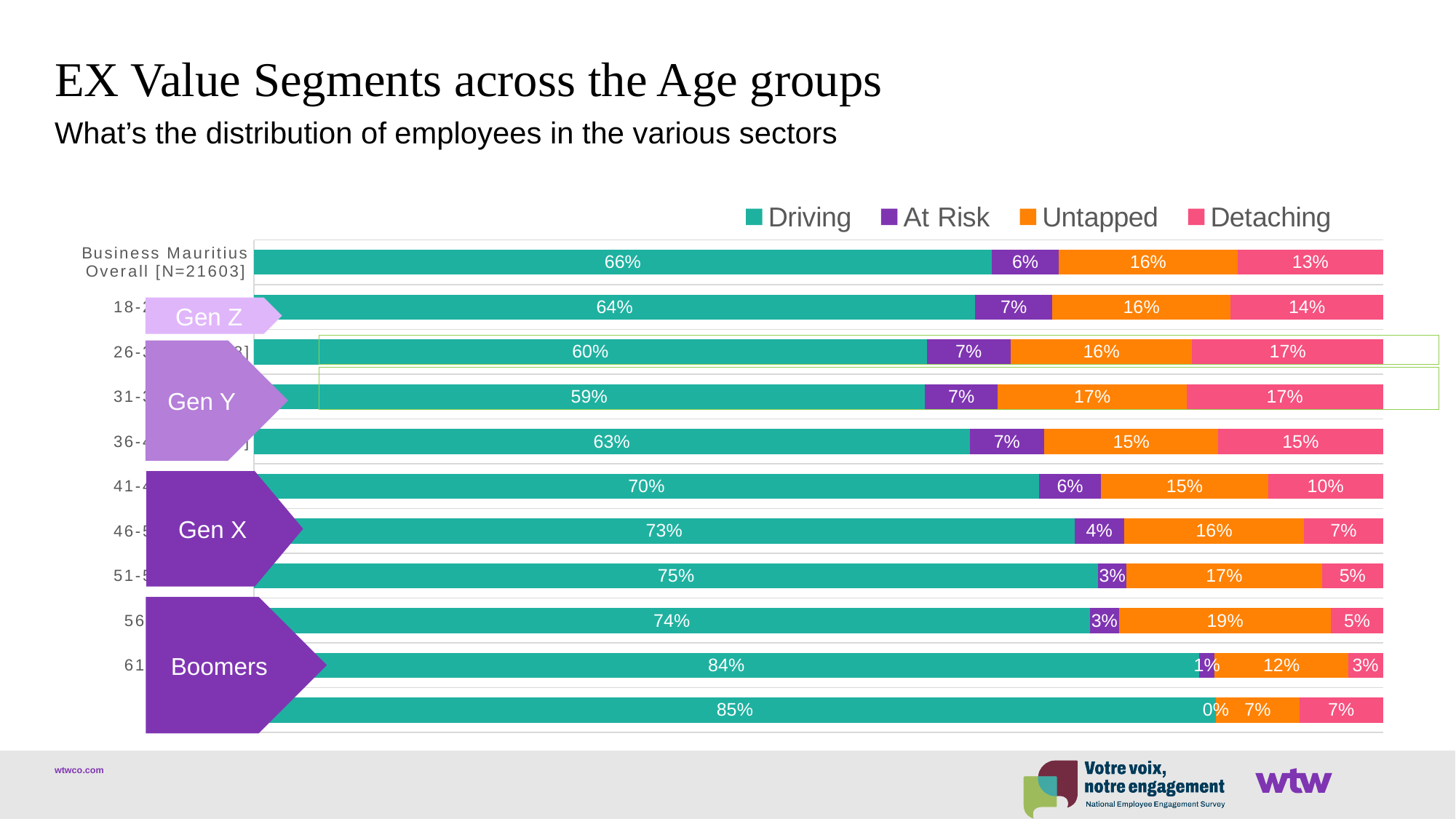
What is the highest Driving value shown on the chart? 85% What is the At Risk value for Business Mauritius Overall [N=21603]? 6% What is the Driving value for Business Mauritius Overall [N=21603]? 66% How many bars are plotted on the chart? 11 For Business Mauritius Overall [N=21603], what is the difference between the Driving and Detaching values? 53 percentage points What is the Detaching value for Business Mauritius Overall [N=21603]? 13% What is the Untapped value for Business Mauritius Overall [N=21603]? 16% What are the legend entries of the chart? Driving, At Risk, Untapped, Detaching How many series does the legend list? 4 Which segment is the smallest in the Business Mauritius Overall [N=21603] bar? At Risk For Business Mauritius Overall [N=21603], which is larger: Untapped or Detaching? Untapped What kind of chart is shown on the slide? Stacked bar chart